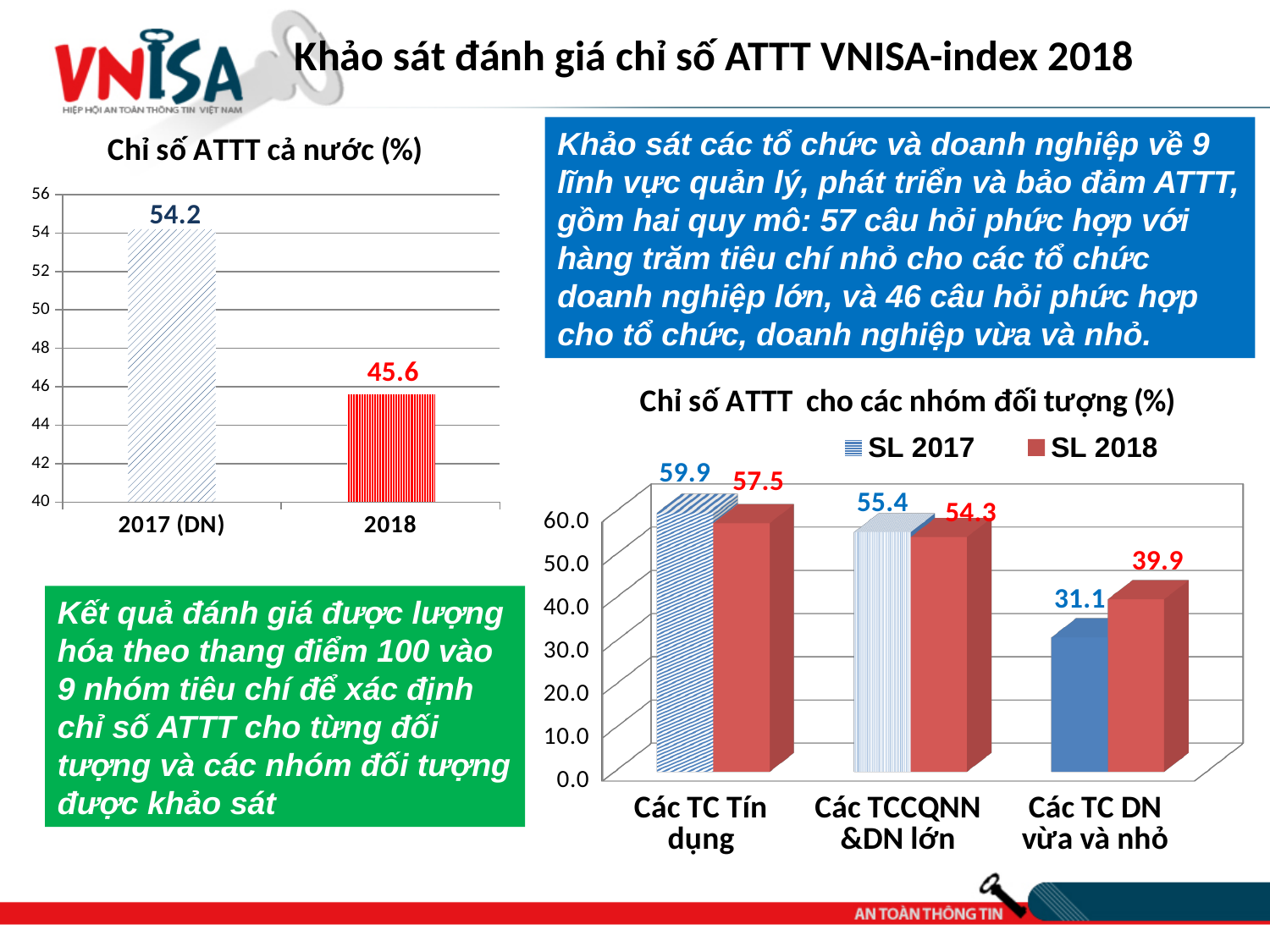
In the chart 'Chỉ số ATTT cho các nhóm đối tượng (%)', which category has the highest SL 2017 value? Các TC Tín dụng In the chart 'Chỉ số ATTT cả nước (%)', what is the value for 2018? 45.6 In the chart 'Chỉ số ATTT cho các nhóm đối tượng (%)', which category has the lowest SL 2018 value? Các TC DN vừa và nhỏ In the chart 'Chỉ số ATTT cho các nhóm đối tượng (%)', what is the SL 2018 value for Các TC DN vừa và nhỏ? 39.9 In the chart 'Chỉ số ATTT cả nước (%)', what is the value for 2017 (DN)? 54.2 How many series does the legend of the chart 'Chỉ số ATTT cho các nhóm đối tượng (%)' list? 2 What kind of chart is 'Chỉ số ATTT cho các nhóm đối tượng (%)'? bar chart In the chart 'Chỉ số ATTT cả nước (%)', do the values rise or fall from 2017 (DN) to 2018? fall In the chart 'Chỉ số ATTT cả nước (%)', what is the difference between the 2017 (DN) value and the 2018 value? 8.6 In the chart 'Chỉ số ATTT cho các nhóm đối tượng (%)', which is larger for Các TC Tín dụng: SL 2017 or SL 2018? SL 2017 In the chart 'Chỉ số ATTT cho các nhóm đối tượng (%)', what is the difference between the SL 2018 and SL 2017 values for Các TC DN vừa và nhỏ? 8.8 In the chart 'Chỉ số ATTT cho các nhóm đối tượng (%)', what is the SL 2017 value for Các TCCQNN &DN lớn? 55.4